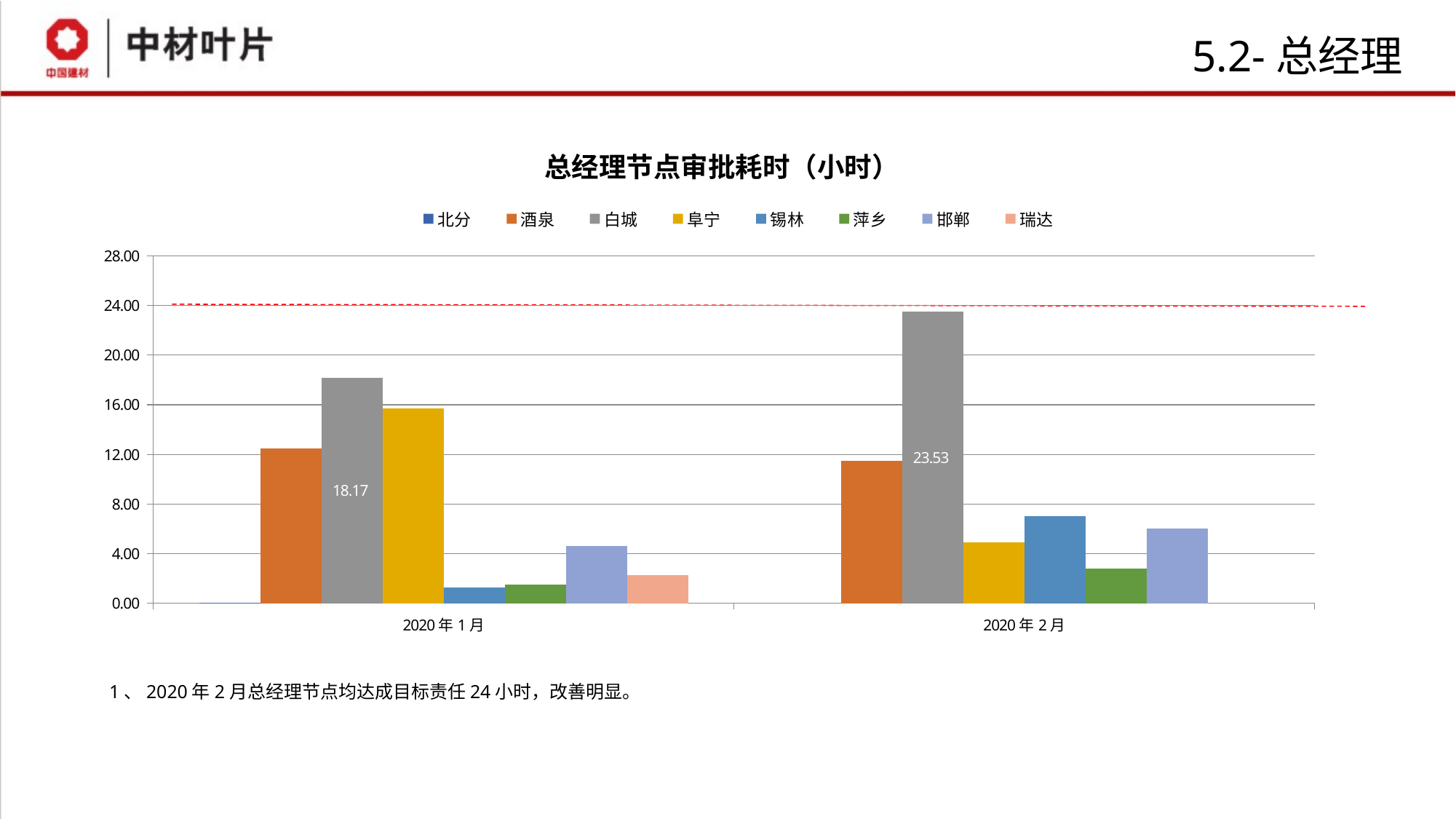
What is the difference between the 白城 values for 2020年2月 and 2020年1月? 5.36 Which series has the highest value in 2020年1月? 白城 What kind of chart is shown on the slide? bar chart How many series does the legend list? 8 Is the value for 阜宁 in 2020年1月 greater or less than 12.00? greater How many categories are shown on the x axis? 2 What is the value for 白城 in 2020年1月? 18.17 What is the title of the chart? 总经理节点审批耗时（小时） What is the value for 白城 in 2020年2月? 23.53 Which series has the lowest value in 2020年2月? 萍乡 Is the 白城 value larger in 2020年1月 or 2020年2月? 2020年2月 Is the value for 锡林 in 2020年2月 greater or less than 8.00? less